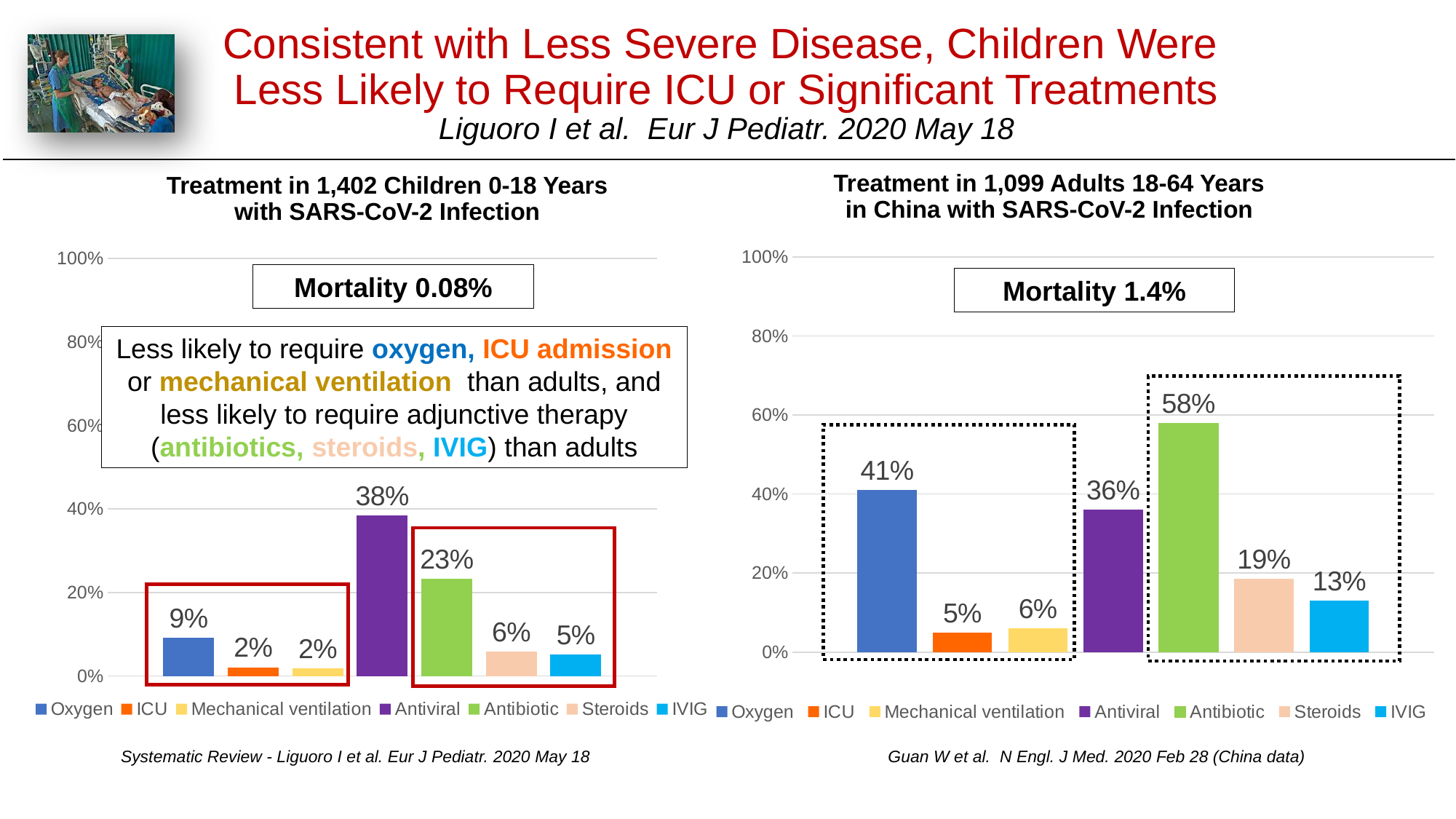
How many series does the legend of the adults' chart on the right list? 7 In the adults' chart on the right, which treatment has the lowest percentage? ICU How many treatment categories are plotted in the children's chart on the left? 7 In the children's chart on the left, what is the difference between the oxygen percentage and the ICU percentage? 7% Is the steroids percentage larger in the children's chart (left) or the adults' chart (right)? Adults' chart (right) In the adults' chart on the right, which treatment has the highest percentage? Antibiotic What is the difference between the antibiotic percentage in the adults' chart (right) and the antibiotic percentage in the children's chart (left)? 35% In the 'Treatment in 1,099 Adults 18-64 Years in China with SARS-CoV-2 Infection' chart, what percentage of adults received oxygen? 41% In the 'Treatment in 1,402 Children 0-18 Years with SARS-CoV-2 Infection' chart, what percentage of children received antiviral treatment? 38% What type of chart is the 'Treatment in 1,099 Adults 18-64 Years in China with SARS-CoV-2 Infection' chart? Bar chart In the adults' chart on the right, is the value for antibiotic greater or less than 40%? greater In the children's chart on the left, which treatment has the highest percentage? Antiviral